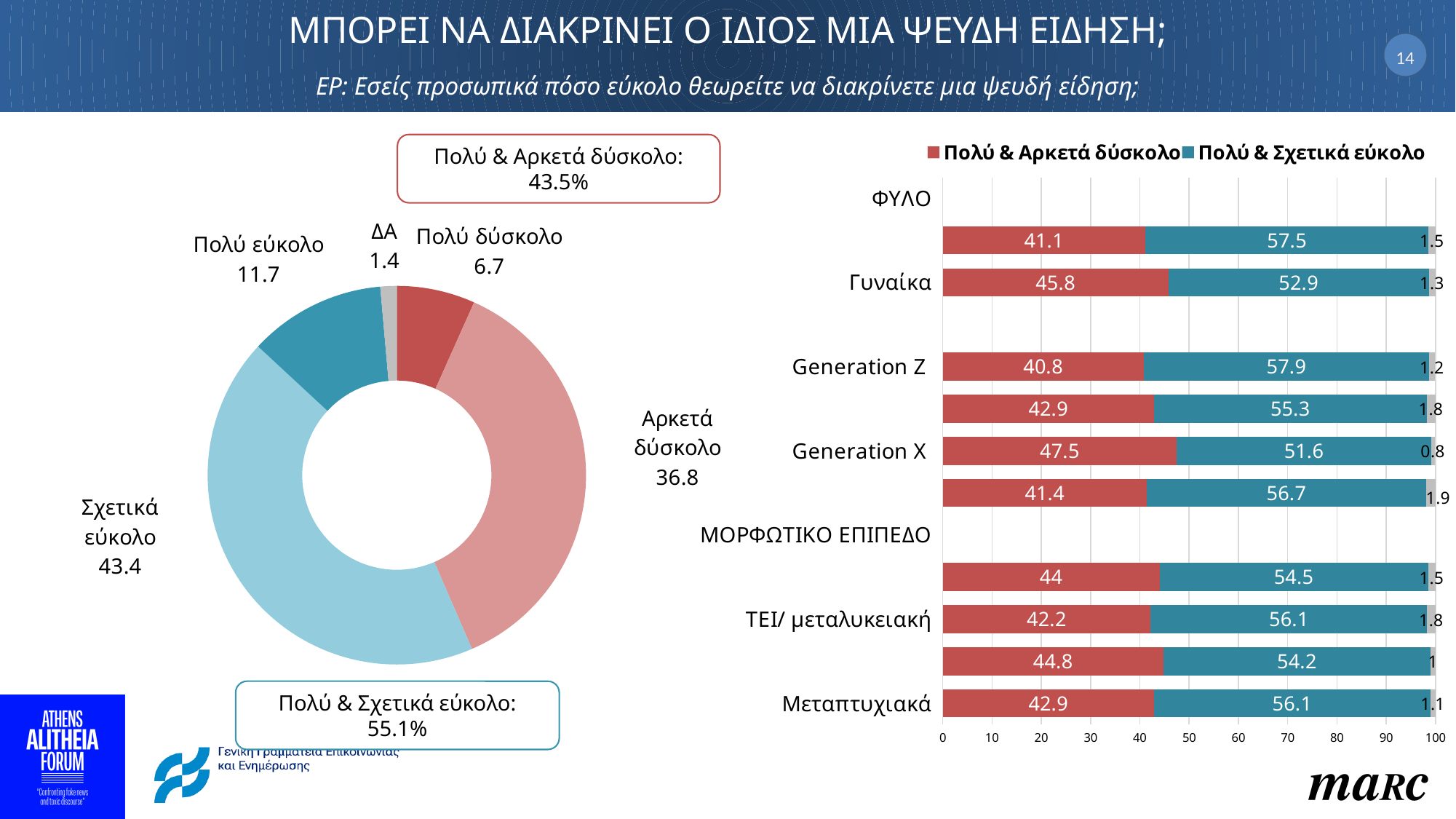
In the doughnut chart on the left, what is the difference between Αρκετά δύσκολο and Πολύ εύκολο? 25.1 In the doughnut chart on the left, which category has the smallest slice? ΔΑ In the stacked bar chart on the right, what is the value of Πολύ & Αρκετά δύσκολο for Generation X? 47.5 In the stacked bar chart on the right, what is the difference between Πολύ & Σχετικά εύκολο and Πολύ & Αρκετά δύσκολο for Μεταπτυχιακά? 13.2 How many slices does the doughnut chart on the left have? 5 In the doughnut chart on the left, which category has the largest slice? Σχετικά εύκολο What kind of chart is shown on the right of the slide? Bar chart In the stacked bar chart on the right, what is the value of Πολύ & Σχετικά εύκολο for Γυναίκα? 52.9 In the doughnut chart on the left, what is the value for Σχετικά εύκολο? 43.4 How many series does the legend of the stacked bar chart on the right list? 2 In the stacked bar chart on the right, which has the larger Πολύ & Σχετικά εύκολο value, Generation Z or Generation X? Generation Z What kind of chart is shown on the left of the slide? Doughnut (pie) chart